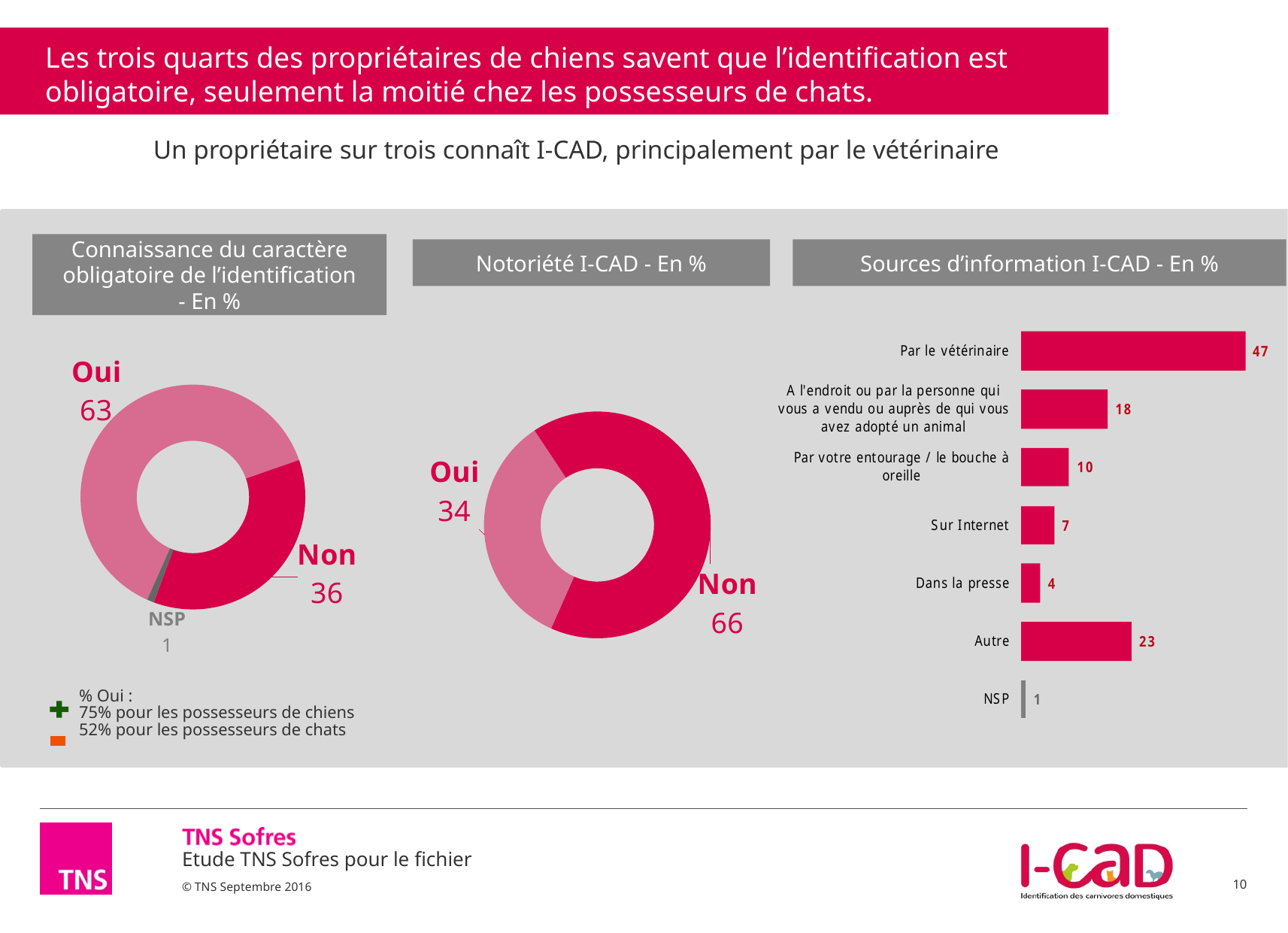
What kind of chart is the 'Sources d'information I-CAD' chart? Bar chart In the 'Connaissance du caractère obligatoire de l'identification' chart, what is the difference between Oui and Non? 27 In the 'Notoriété I-CAD' chart, what is the value for Non? 66 What kind of chart is the 'Notoriété I-CAD' chart? Donut (pie) chart In the 'Sources d'information I-CAD' chart, what is the value for Par le vétérinaire? 47 How many categories are shown in the 'Sources d'information I-CAD' chart? 7 In the 'Connaissance du caractère obligatoire de l'identification' chart, what is the value for Oui? 63 In the 'Sources d'information I-CAD' chart, which category has the lowest value? NSP In the 'Sources d'information I-CAD' chart, what is the difference between Autre and Sur Internet? 16 In the 'Notoriété I-CAD' chart, which is larger, Oui or Non? Non In the 'Sources d'information I-CAD' chart, which source has the highest value? Par le vétérinaire In the 'Connaissance du caractère obligatoire de l'identification' chart, what is the value for NSP? 1